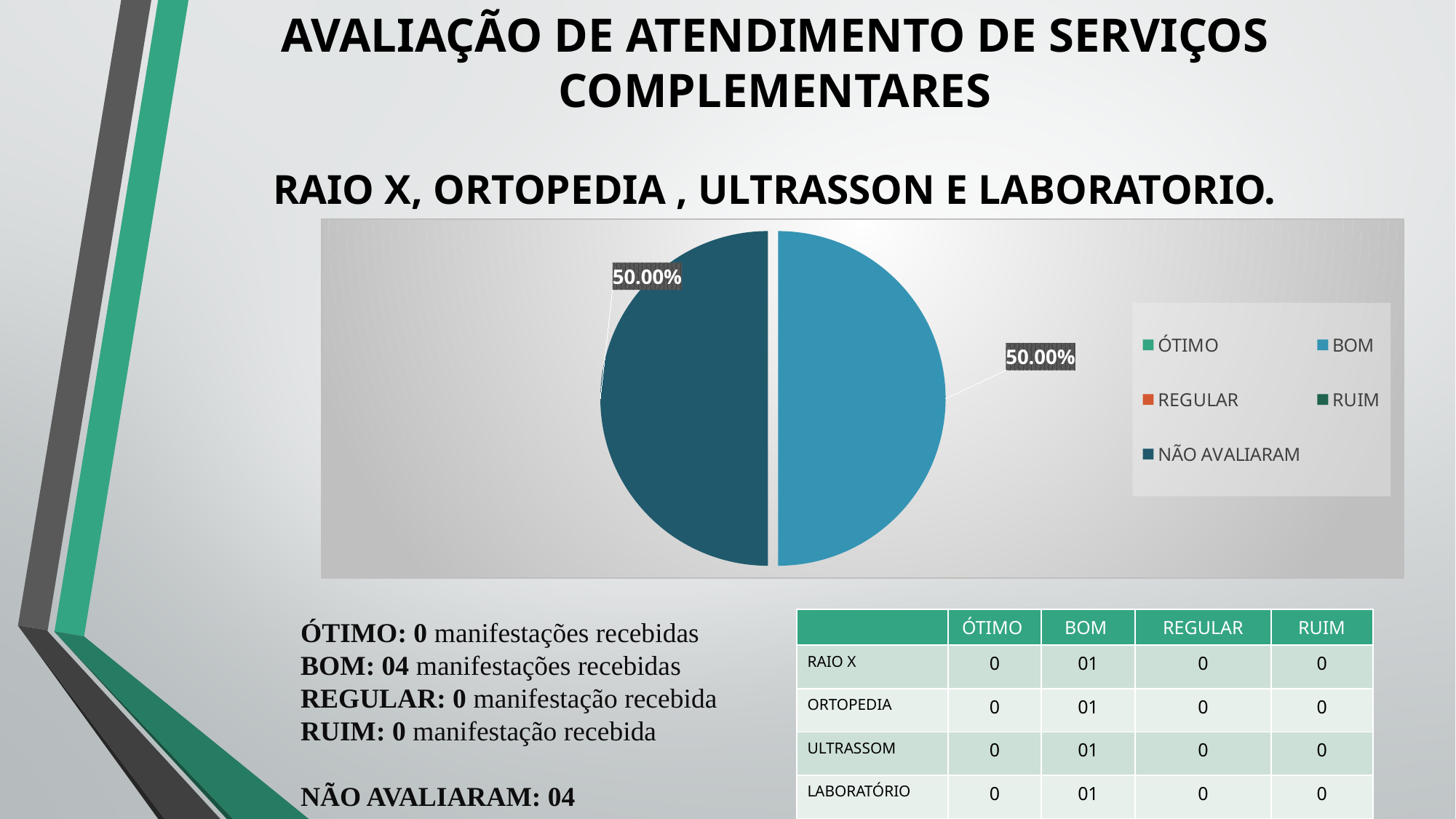
What kind of chart is shown on the slide? pie chart Which legend entries correspond to the two visible slices of the pie? BOM and NÃO AVALIARAM Is the share for NÃO AVALIARAM greater or less than 75%? less Which legend entry is shown with an orange marker? REGULAR What share of the pie does the BOM slice represent? 50.00% Is the share for BOM greater or less than 25%? greater How many slices are visible in the pie chart? 2 What share of the pie does the NÃO AVALIARAM slice represent? 50.00% How many entries does the chart legend list? 5 What is the combined share of the BOM and NÃO AVALIARAM slices? 100.00%